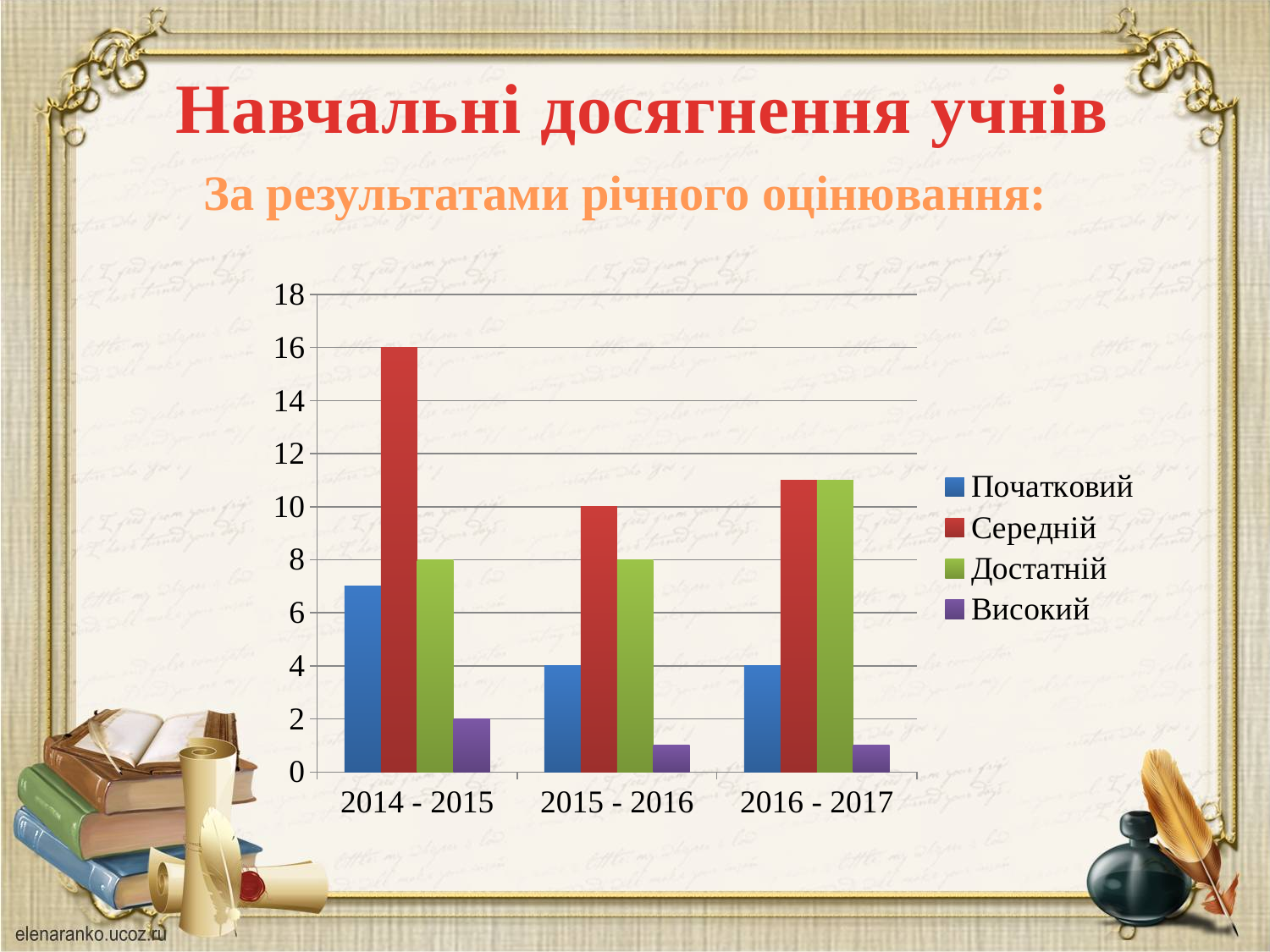
How many series does the legend list? 4 How many year categories are shown on the x axis? 3 What is the value for Середній in 2014 - 2015? 16 What is the value for Початковий in 2016 - 2017? 4 Is the value for Початковий in 2014 - 2015 greater or less than 6? greater What is the value for Достатній in 2014 - 2015? 8 Which is larger: Середній in 2014 - 2015 or Середній in 2015 - 2016? Середній in 2014 - 2015 What is the value for Середній in 2015 - 2016? 10 Which series has the highest value in 2014 - 2015? Середній Is the value for Достатній in 2016 - 2017 greater or less than 10? greater Which series has the lowest value in 2015 - 2016? Високий What kind of chart is shown on the slide? bar chart